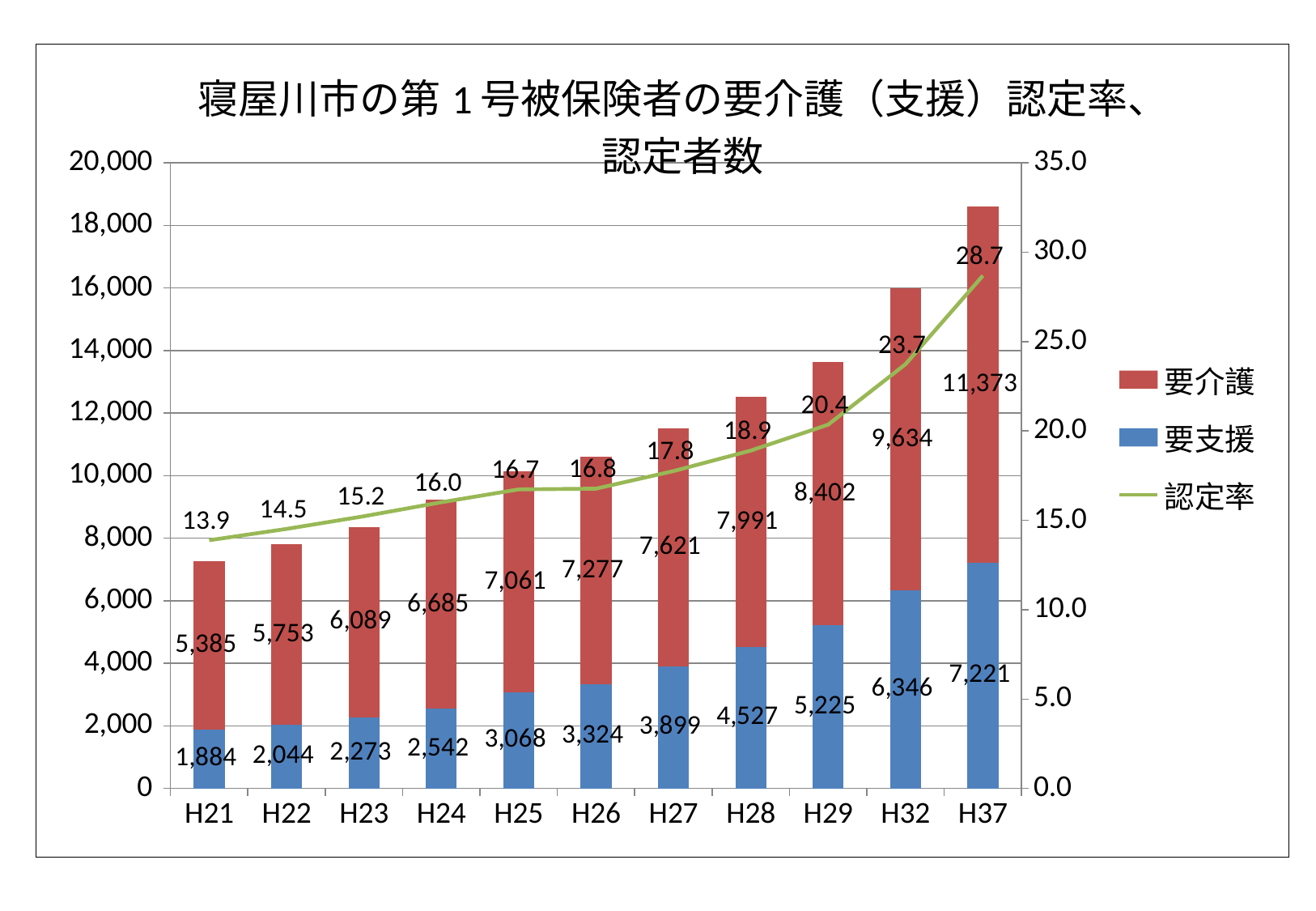
Does the 認定率 line rise or fall from H21 to H37? rise What is the value of 要支援 for H37? 7,221 Which category has the lowest 要支援 value? H21 Which is larger, the 要支援 value for H28 or for H27? H28 How many categories are shown on the x axis? 11 Which category has the highest 要介護 value? H37 What is the total of the stacked bar for H21 (要介護 plus 要支援)? 7,269 What is the difference between the 要介護 values for H37 and H32? 1,739 What is the 認定率 value for H29? 20.4 What colour represents 要支援 in the chart? blue How many series does the legend list? 3 What is the value of 要介護 for H21? 5,385